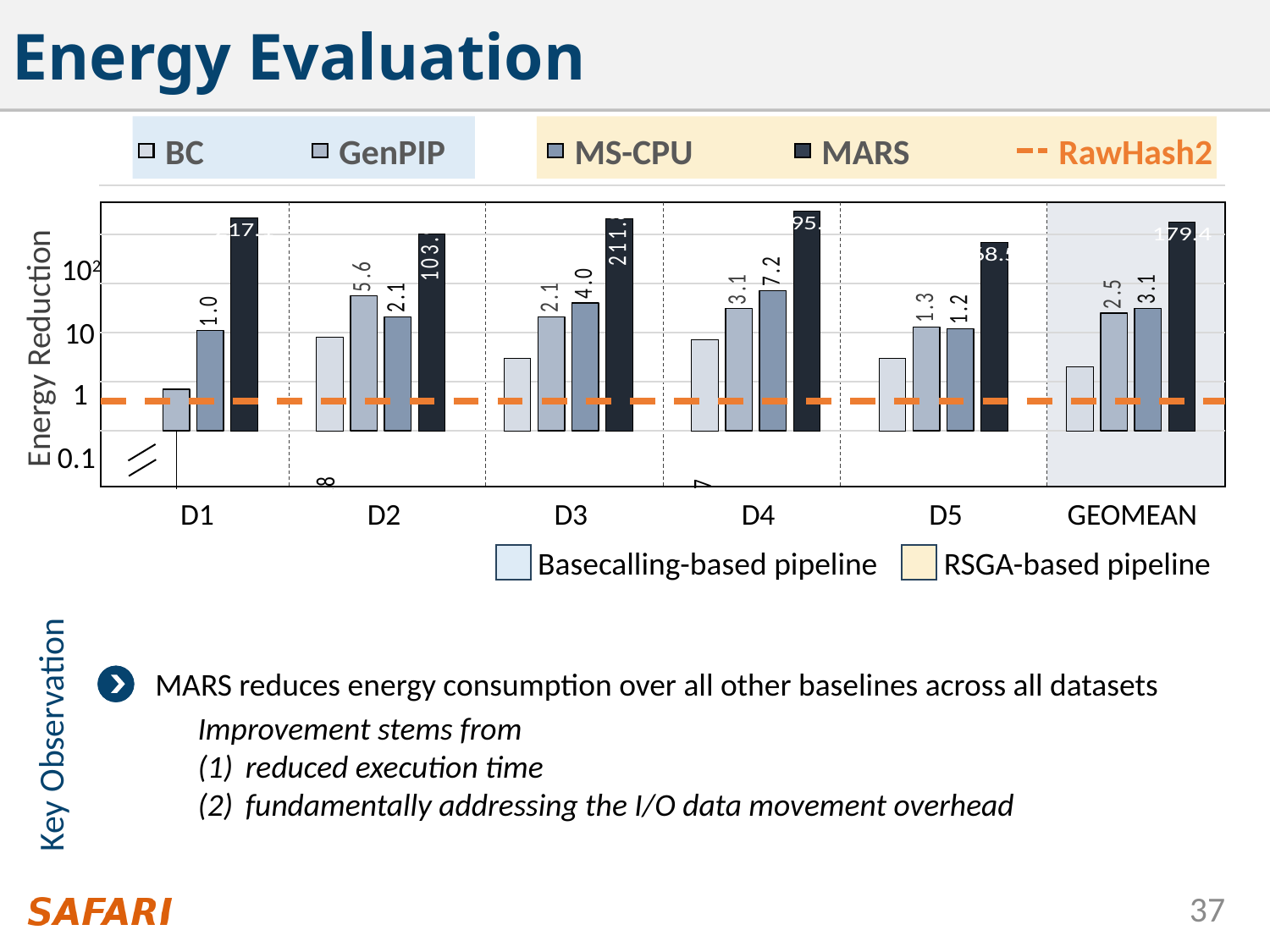
Is the MARS bar for D4 greater or less than 100? greater How many categories are shown along the x axis of the chart? 6 Which series has the highest bar in the GEOMEAN group? MARS What is the difference between the labelled MS-CPU value (3.1) and the labelled GenPIP value (2.5) for GEOMEAN? 0.6 What is the labelled value of the GenPIP bar for GEOMEAN? 2.5 How many entries does the chart legend list? 5 What is the title of the y axis of the chart? Energy Reduction What is the labelled value of the MARS bar for GEOMEAN? 179.4 What is the labelled value of the MS-CPU bar for D4? 7.2 What kind of chart is shown on the slide? bar chart In the D4 group, which is larger: the MS-CPU bar or the GenPIP bar? MS-CPU